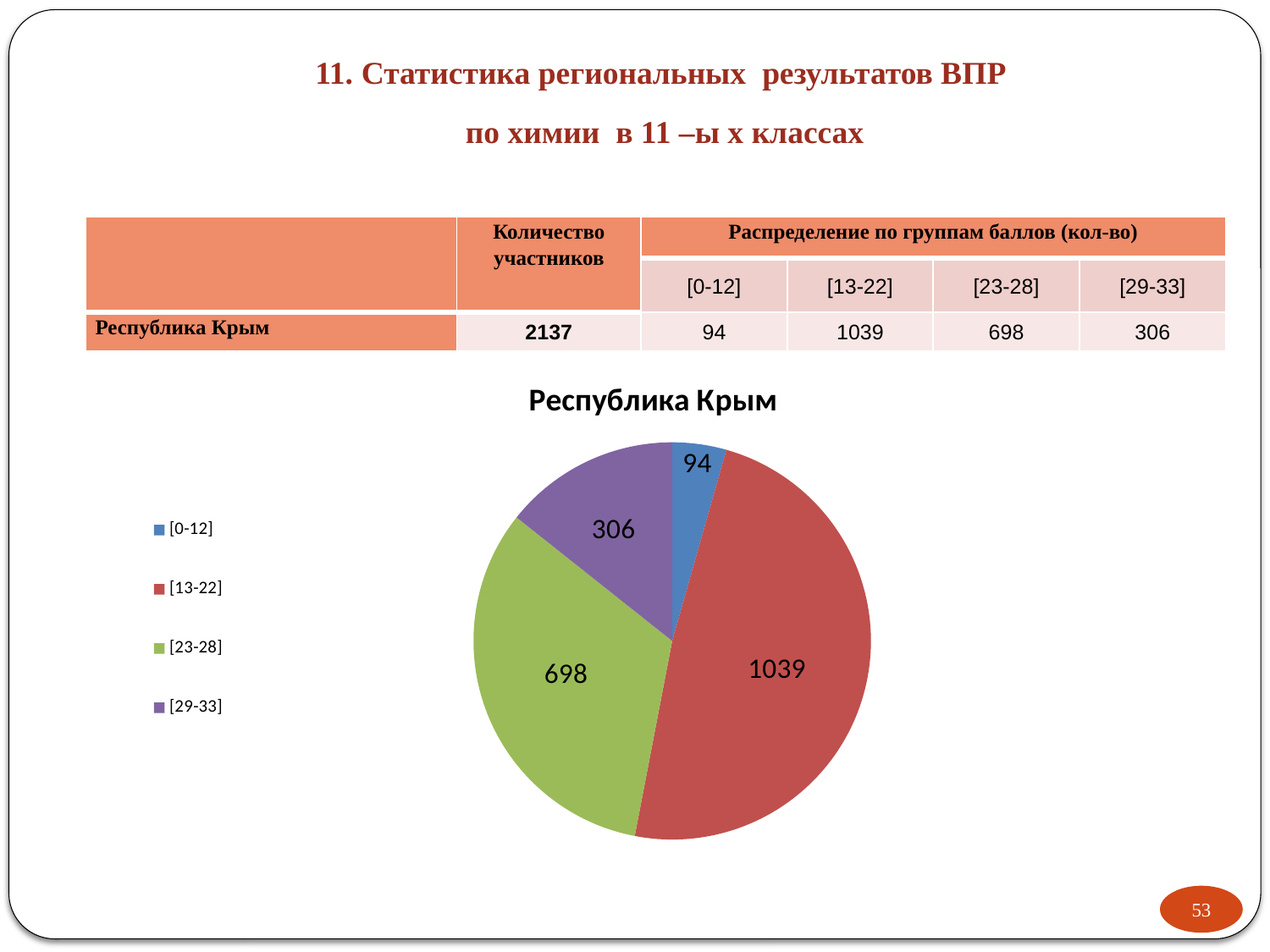
How many entries does the legend list? 4 Which score group has the largest slice? [13-22] What share of the pie does the [13-22] slice represent? 48.6% What is the chart's title? Республика Крым What is the value for the [29-33] slice? 306 What is the value for the [0-12] slice? 94 Which is larger, the [23-28] slice or the [29-33] slice? [23-28] What is the value for the [13-22] slice? 1039 What is the difference between the [13-22] and [23-28] values? 341 How many slices does the pie chart have? 4 What kind of chart is shown on the slide? pie chart Which score group has the smallest slice? [0-12]